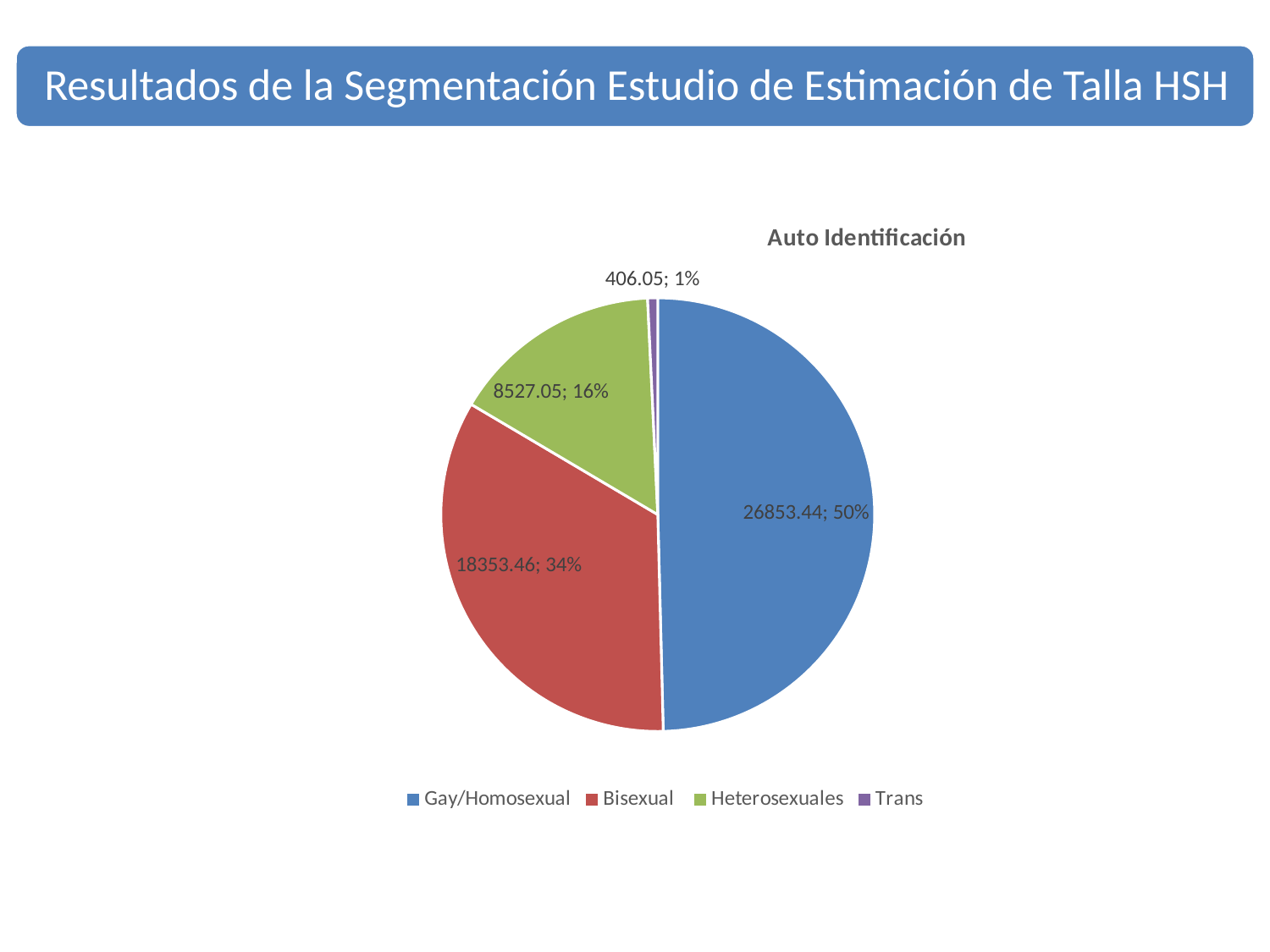
What value is shown for the Heterosexuales slice? 8527.05 What value is shown for the Gay/Homosexual slice? 26853.44 What share of the pie does the Heterosexuales slice represent? 16% What is the difference between the Gay/Homosexual value and the Bisexual value? 8499.98 What is the title of the chart? Auto Identificación How many slices does the pie chart have? 4 What value is shown for the Bisexual slice? 18353.46 Which category has the largest slice? Gay/Homosexual What type of chart is shown on the slide? pie chart What share of the pie does the Bisexual slice represent? 34% Which category has the smallest slice? Trans What value is shown for the Trans slice? 406.05